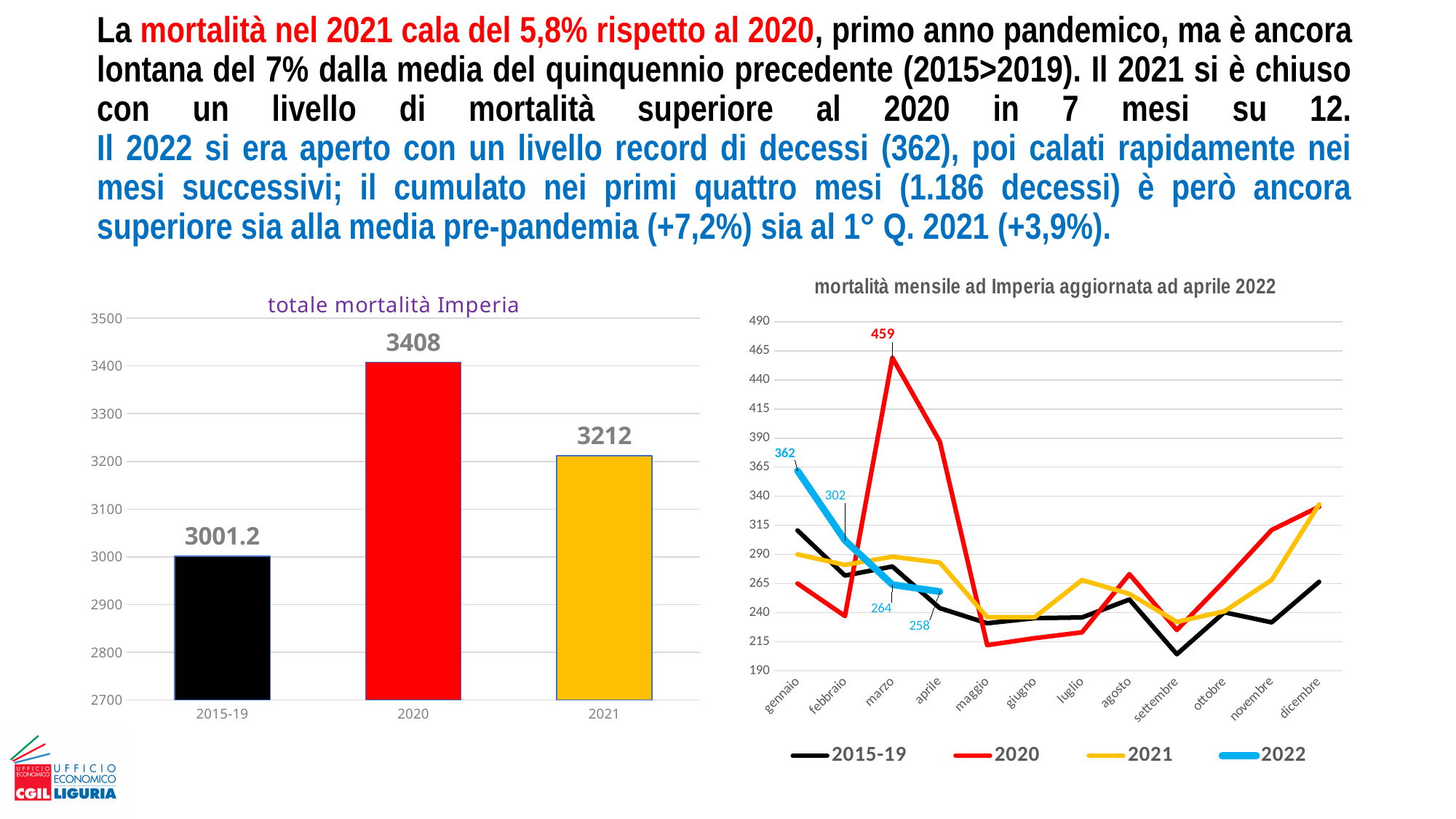
In the chart titled "mortalità mensile ad Imperia aggiornata ad aprile 2022", does the 2022 series rise or fall from gennaio to aprile? fall In the chart titled "mortalità mensile ad Imperia aggiornata ad aprile 2022", what is the labelled value of the 2020 series in marzo? 459 In the chart titled "totale mortalità Imperia", what is the difference between the 2020 and 2021 values? 196 What kind of chart is the one titled "totale mortalità Imperia"? bar chart In the chart titled "totale mortalità Imperia", how many categories are shown? 3 In the chart titled "totale mortalità Imperia", which category has the highest value? 2020 In the chart titled "totale mortalità Imperia", what is the value for 2020? 3408 In the chart titled "totale mortalità Imperia", which category has the lowest value? 2015-19 In the chart titled "mortalità mensile ad Imperia aggiornata ad aprile 2022", what is the labelled value of the 2022 series in gennaio? 362 In the chart titled "mortalità mensile ad Imperia aggiornata ad aprile 2022", is the value of the 2015-19 series in settembre greater or less than 215? less In the chart titled "totale mortalità Imperia", what is the value for 2015-19? 3001.2 In the chart titled "mortalità mensile ad Imperia aggiornata ad aprile 2022", how many series does the legend list? 4